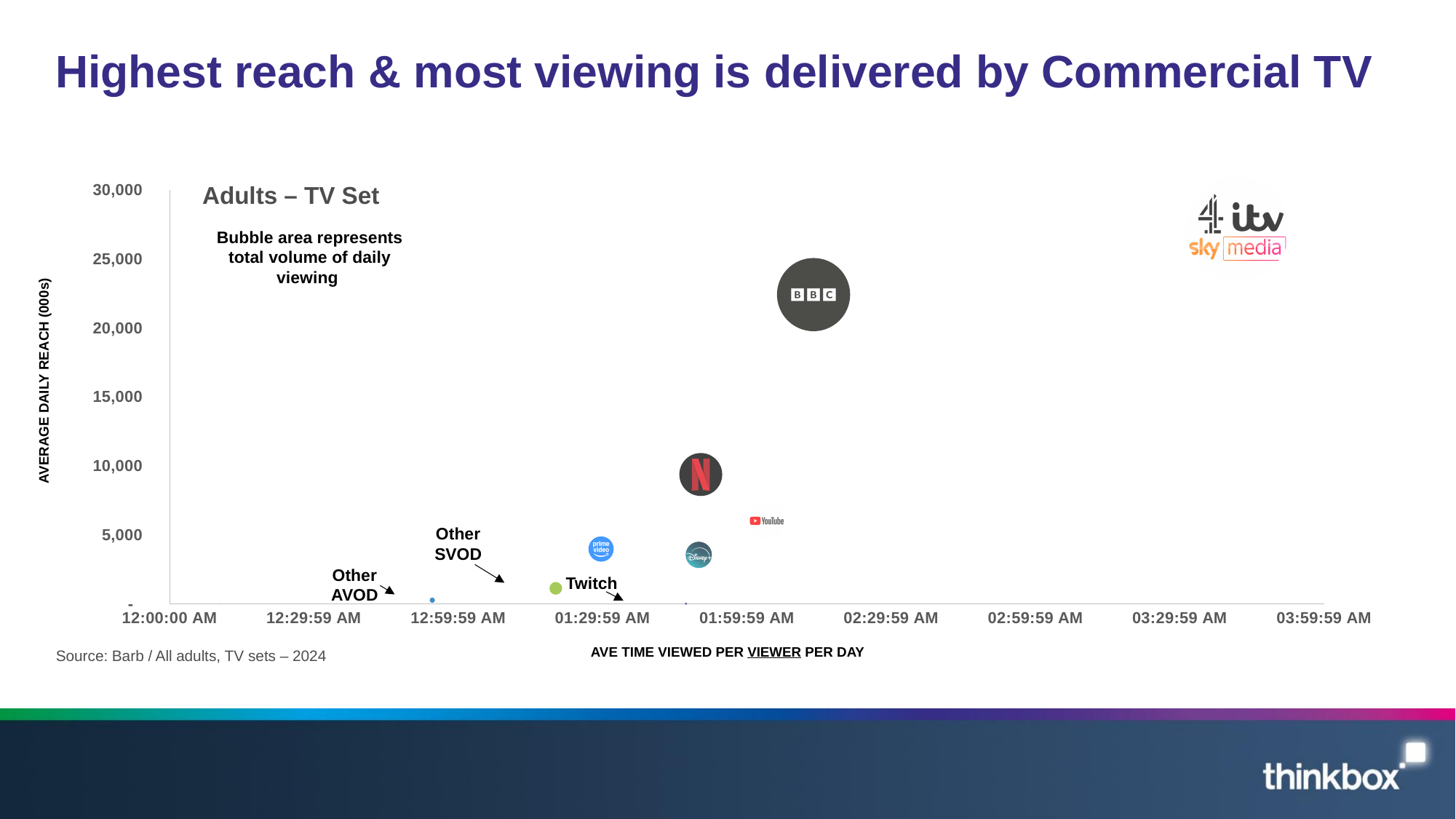
Is the average daily reach for Netflix greater or less than 15,000? less Is the average daily reach for Twitch greater or less than 5,000? less Is the average daily reach for BBC greater or less than 20,000? greater Which has the higher average daily reach, BBC or Netflix? BBC Which has the higher average daily reach, Prime Video or Twitch? Prime Video Which has the longer average time viewed per viewer per day, BBC or Netflix? BBC What is the label of the vertical axis of the chart? AVERAGE DAILY REACH (000s) According to the note on the chart, what does the bubble area represent? Total volume of daily viewing What kind of chart is shown on the slide? Bubble chart